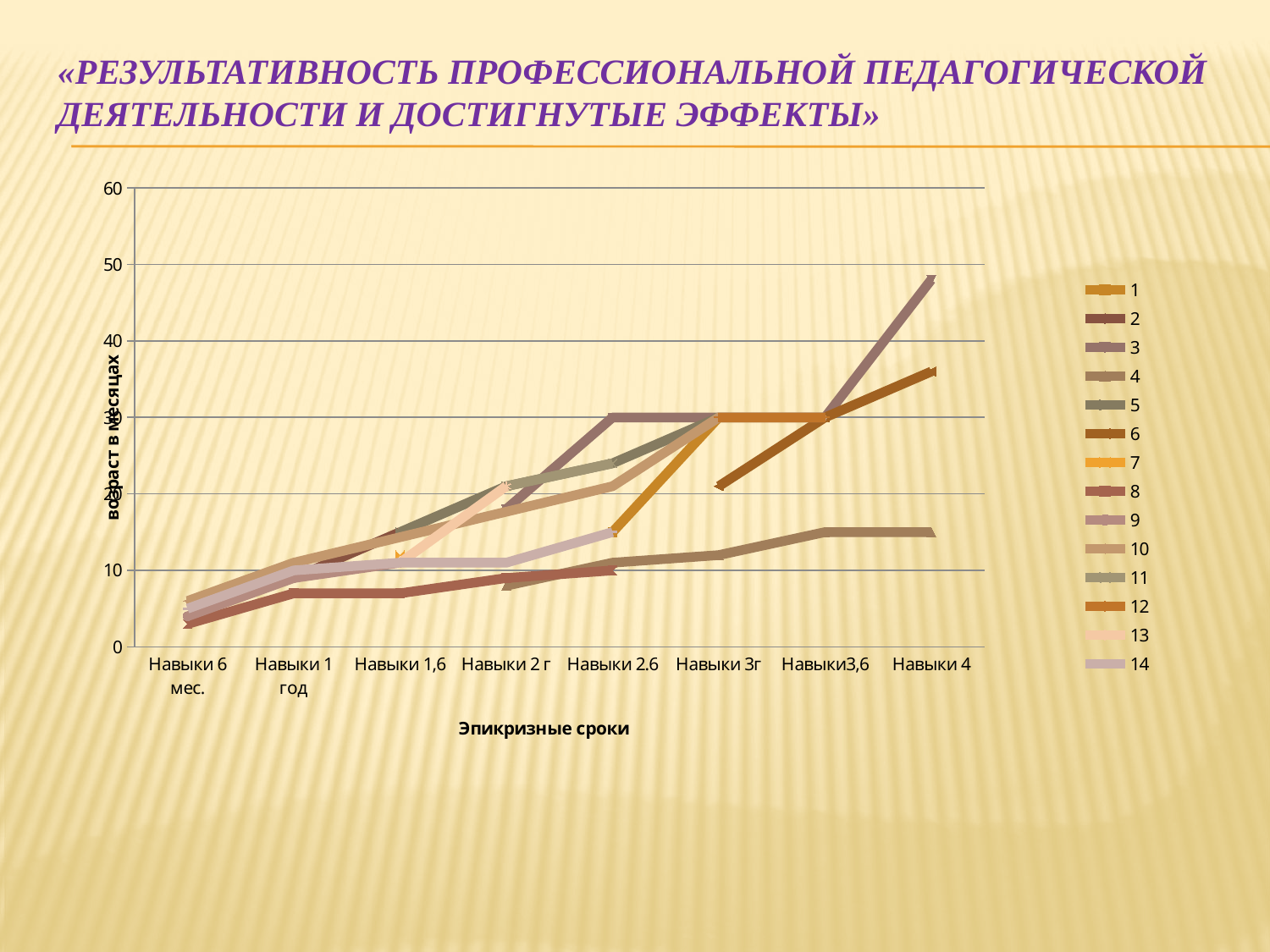
What kind of chart is shown on the slide? line chart What is the title of the x axis of the chart? Эпикризные сроки Are all plotted values at the category 'Навыки 6 мес.' greater or less than 10? less How many series does the chart's legend list? 14 What is the maximum value shown on the y axis of the chart? 60 At which x-axis category does the chart reach its highest plotted value? Навыки 4 How many categories are shown along the x axis of the chart? 8 Is the highest plotted value on the chart greater or less than 40? greater What is the title of the y axis of the chart? возраст в месяцах Do the plotted values generally rise or fall from left to right along the x axis? rise